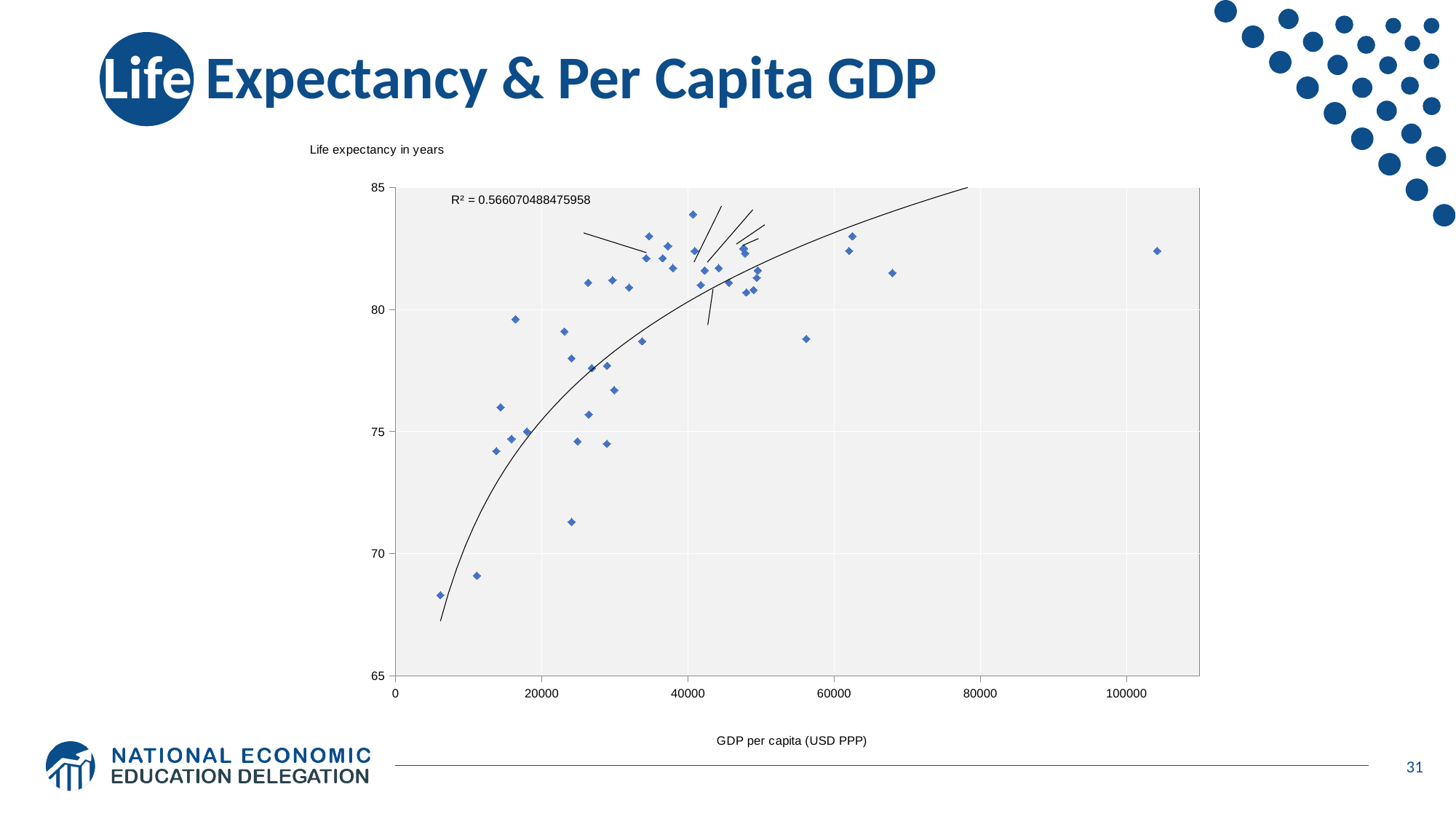
What kind of chart is shown on the slide? scatter plot What is the highest value shown on the vertical axis? 85 Is the GDP per capita of the leftmost point greater or less than 20000? less Is the life expectancy of the point with the highest GDP per capita greater or less than 80? greater Is the life expectancy of the highest point on the chart greater or less than 80? greater As GDP per capita increases along the x axis, does life expectancy generally rise or fall? rise What is the R² value printed on the chart? R² = 0.566070488475958 What is the lowest value shown on the vertical axis? 65 What is the highest tick value labelled on the horizontal axis? 100000 What is the label of the horizontal axis? GDP per capita (USD PPP)